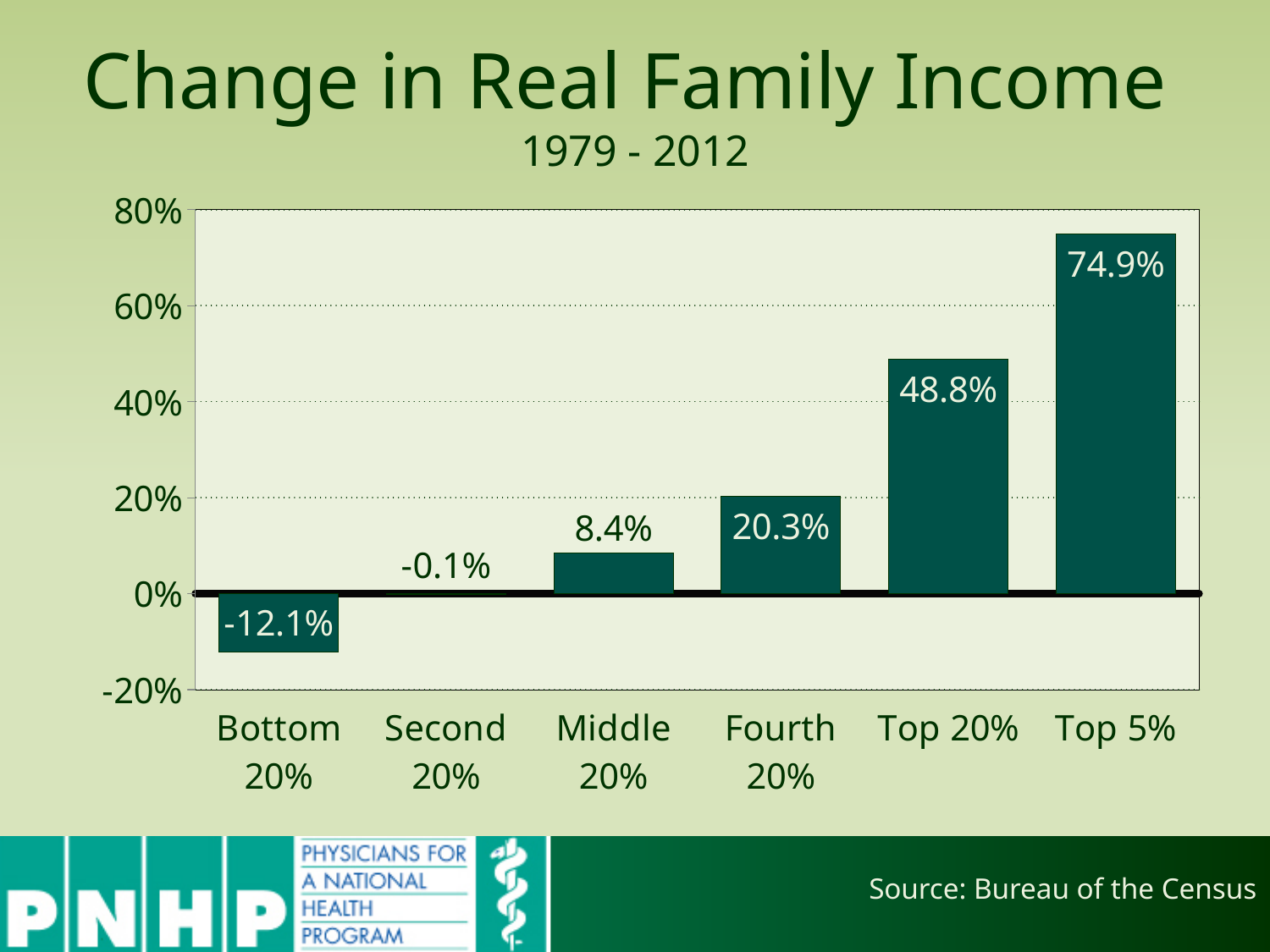
Do the values rise or fall moving from the Bottom 20% to the Top 5%? Rise What is the difference between the change for the Top 5% and the Top 20%? 26.1% How many categories are shown on the chart? 6 What is the change in real family income for the Middle 20%? 8.4% What is the change in real family income for the Top 20%? 48.8% Which category has the highest change in real family income? Top 5% Which has a larger change in real family income, the Fourth 20% or the Middle 20%? Fourth 20% Which category has the lowest change in real family income? Bottom 20% What is the change in real family income for the Top 5%? 74.9% What kind of chart is shown on the slide? Bar chart Is the value for the Top 20% greater or less than 40%? greater What is the change in real family income for the Bottom 20%? -12.1%